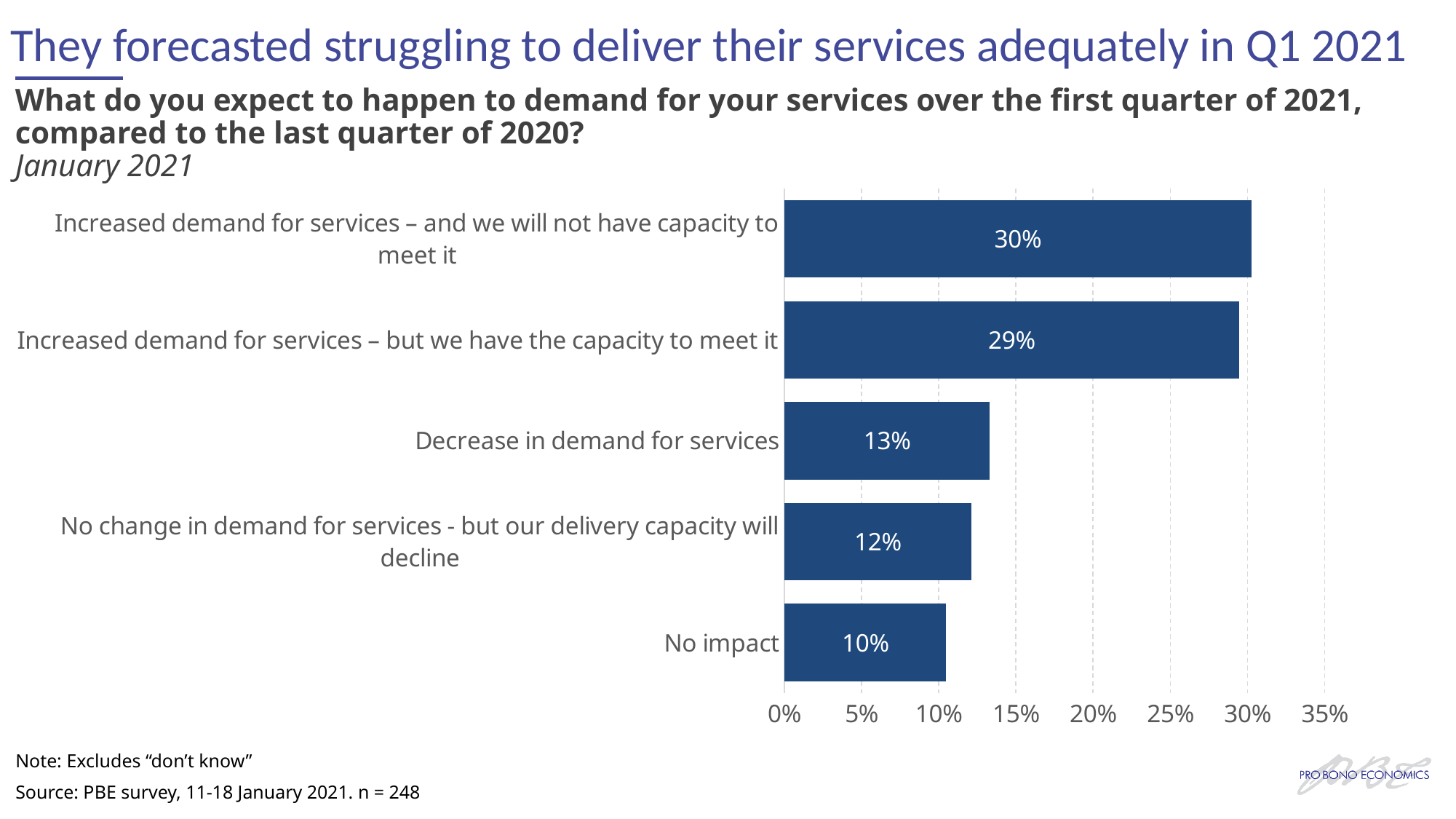
Which category has the highest value? Increased demand for services – and we will not have capacity to meet it Which category has the lowest value? No impact What is the value for 'Decrease in demand for services'? 13% What percentage of respondents expected increased demand for services but with the capacity to meet it? 29% What is the sample size (n) stated in the source note below the chart? 248 What kind of chart is shown on the slide? Bar chart What is the value for 'No impact'? 10% How many categories are shown in the chart? 5 What is the difference between the value for 'Increased demand for services – and we will not have capacity to meet it' and the value for 'No impact'? 20% Which is larger: the value for 'Decrease in demand for services' or the value for 'No impact'? Decrease in demand for services What is the value for 'No change in demand for services - but our delivery capacity will decline'? 12% What is the difference between the values for 'Decrease in demand for services' and 'No change in demand for services - but our delivery capacity will decline'? 1%